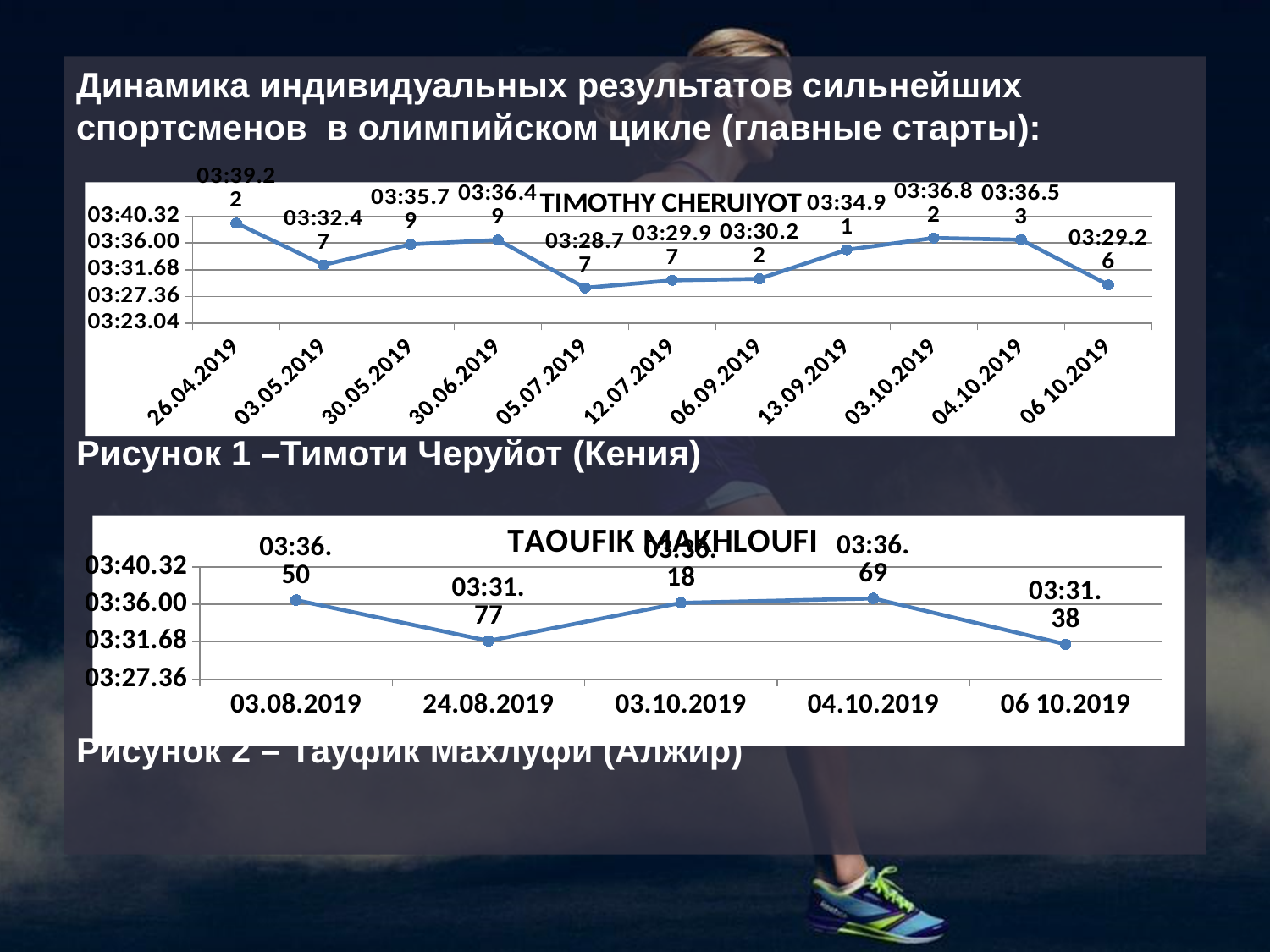
How many data points are plotted in the TAOUFIK MAKHLOUFI chart? 5 In the TIMOTHY CHERUIYOT chart, which date has the lowest value? 05.07.2019 What kind of chart is the TIMOTHY CHERUIYOT chart? Line chart In the TAOUFIK MAKHLOUFI chart, which date has the lowest value? 06 10.2019 What is the title of the lower chart on the slide? TAOUFIK MAKHLOUFI In the TAOUFIK MAKHLOUFI chart, which is larger, the value for 03.08.2019 or for 24.08.2019? 03.08.2019 In the TIMOTHY CHERUIYOT chart, what is the value for 26.04.2019? 03:39.22 In the TIMOTHY CHERUIYOT chart, which date has the highest value? 26.04.2019 In the TIMOTHY CHERUIYOT chart, what is the value for 05.07.2019? 03:28.77 In the TIMOTHY CHERUIYOT chart, does the value rise or fall from 30.06.2019 to 05.07.2019? Fall How many data points are plotted in the TIMOTHY CHERUIYOT chart? 11 In the TAOUFIK MAKHLOUFI chart, what is the value for 24.08.2019? 03:31.77